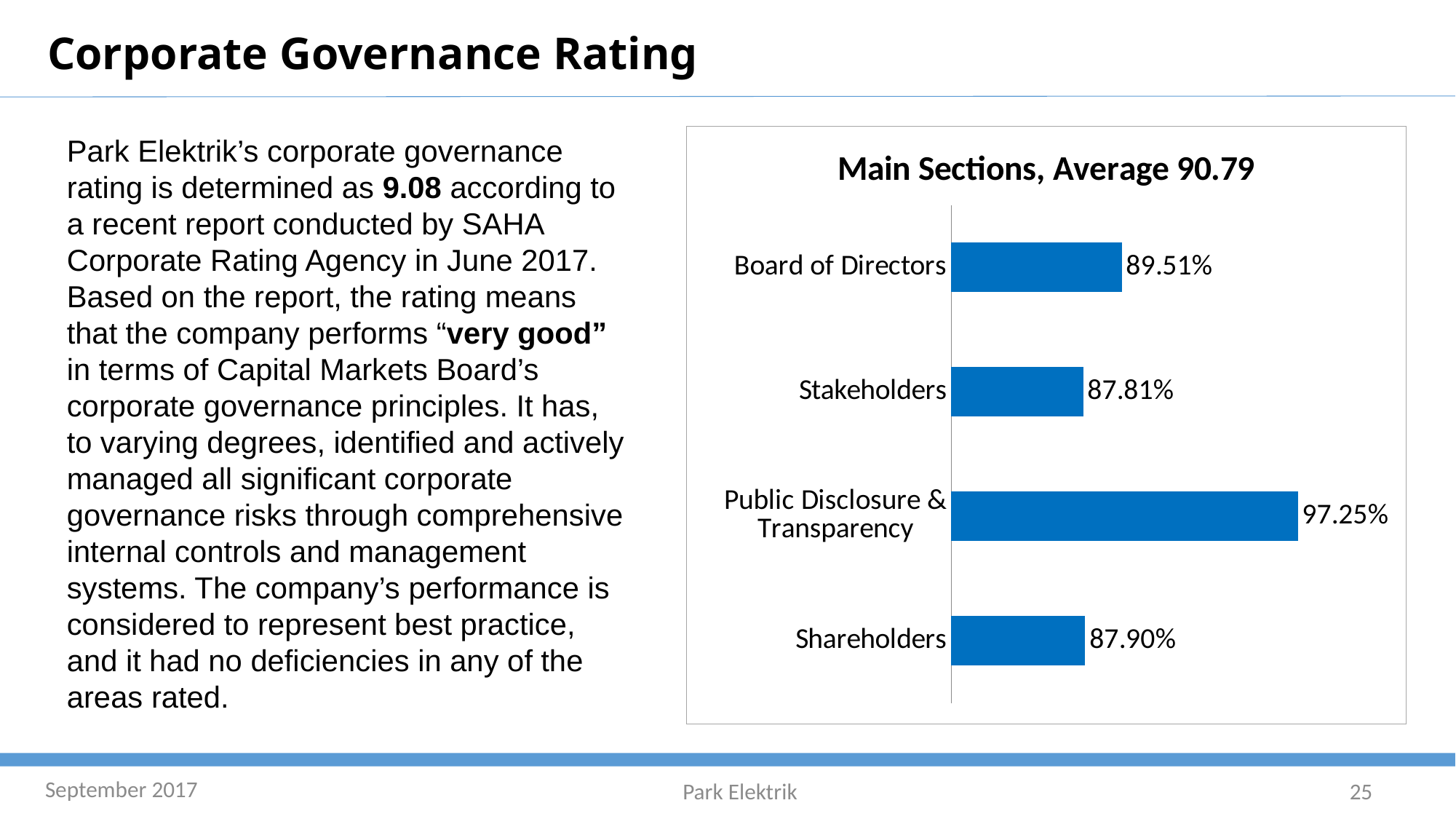
What is the value for Shareholders? 87.90% What is the title of the chart? Main Sections, Average 90.79 What is the value for Public Disclosure & Transparency? 97.25% Which section has the lowest value? Stakeholders What is the difference between the values for Board of Directors and Stakeholders? 1.70 percentage points What is the difference between the values for Public Disclosure & Transparency and Board of Directors? 7.74 percentage points Which section has the highest value? Public Disclosure & Transparency What is the value for Board of Directors? 89.51% What is the value for Stakeholders? 87.81% How many sections are shown in the chart? 4 What kind of chart is shown on the slide? Bar chart Which is larger, the value for Board of Directors or the value for Shareholders? Board of Directors